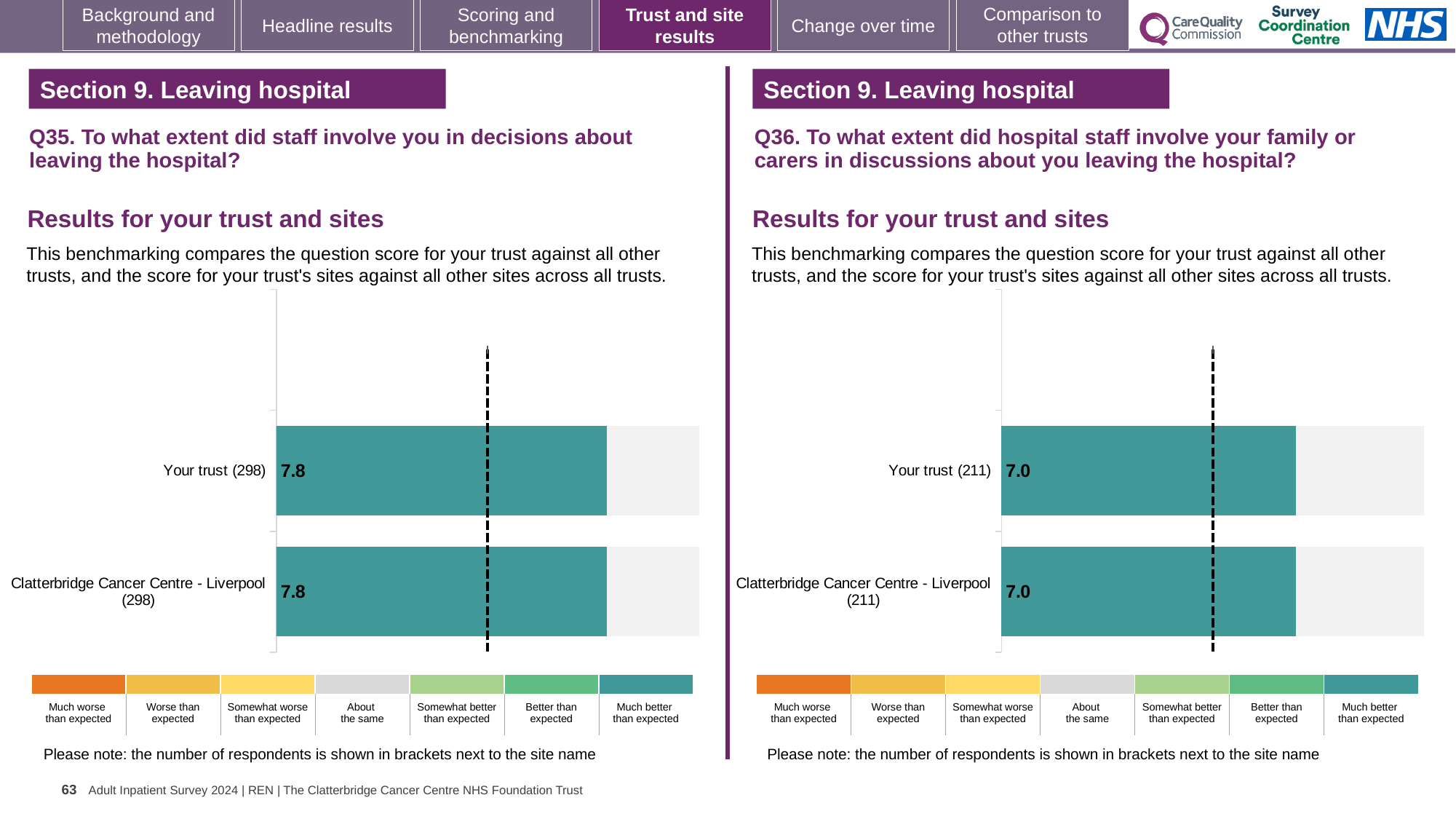
How many categories does the colour key below the Q36 chart on the right list? 7 In the Q35 chart on the left, how many respondents are shown in brackets for Your trust? 298 In the Q36 chart on the right, how many bars are plotted? 2 What is the difference between the Your trust score in the Q35 chart on the left and the Your trust score in the Q36 chart on the right? 0.8 In the Q36 chart on the right, how many respondents are shown in brackets for Clatterbridge Cancer Centre - Liverpool? 211 In the Q36 chart on the right, what is the score for Clatterbridge Cancer Centre - Liverpool? 7.0 In the Q36 chart on the right, what is the score for Your trust? 7.0 In the Q35 chart on the left, which category of the colour key does the teal colour of the bars correspond to? Much better than expected In the Q35 chart on the left, how many bars are plotted? 2 In the Q35 chart on the left, what is the score for Your trust? 7.8 What kind of chart is used for the Q35 results on the left? Bar chart In the Q35 chart on the left, what is the score for Clatterbridge Cancer Centre - Liverpool? 7.8